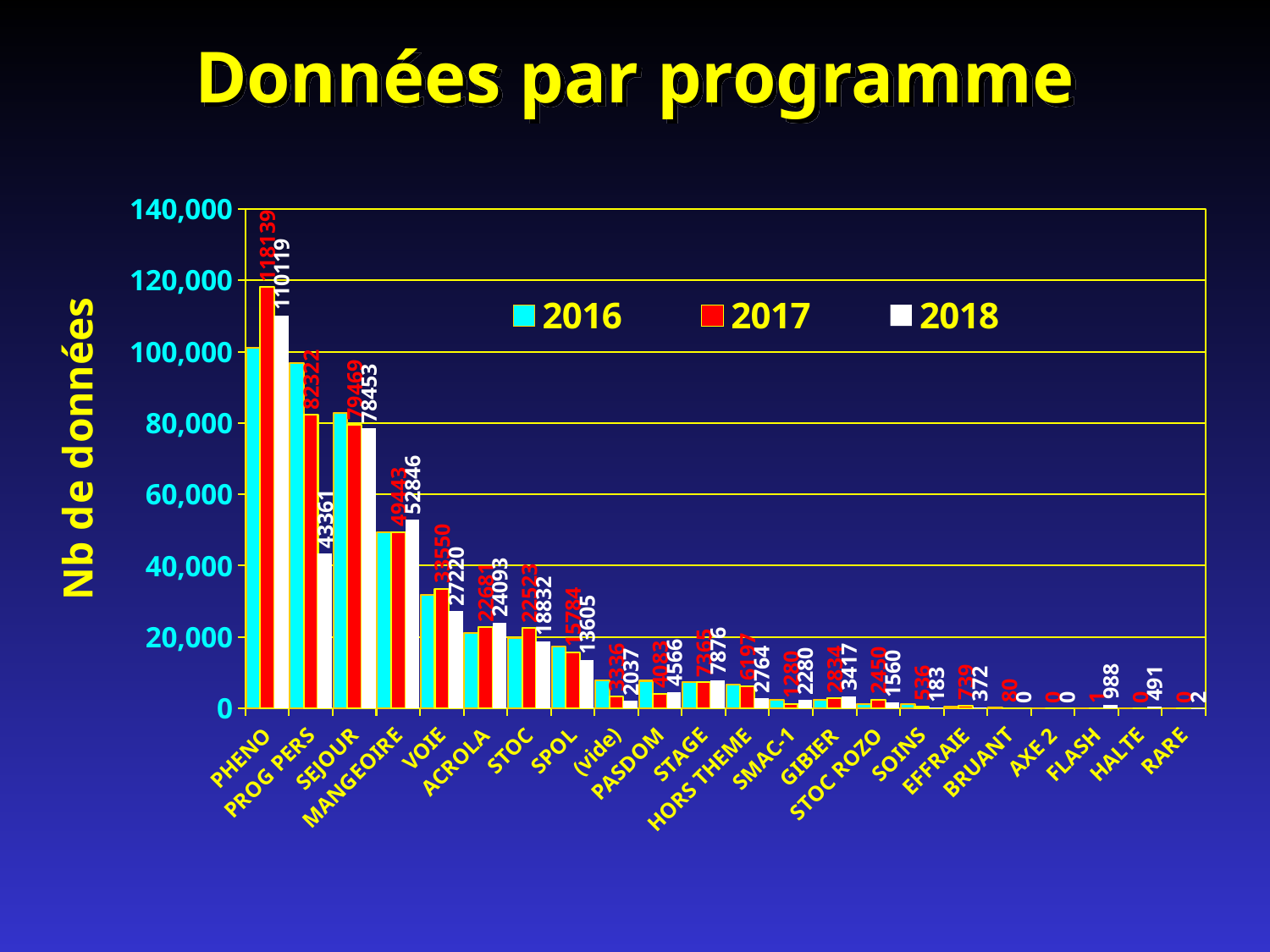
Is the 2016 value for VOIE greater or less than 20,000? greater Which programme has the highest 2018 value? PHENO What is the 2018 value for MANGEOIRE? 52846 What is the 2018 value for PHENO? 110119 What kind of chart is shown on the slide? bar chart How many programme categories are shown on the x axis? 22 What is the difference between the 2017 and 2018 values for PROG PERS? 38961 What is the 2018 value for HALTE? 491 Which is larger in 2018: MANGEOIRE or PROG PERS? MANGEOIRE How many series does the legend list? 3 What is the title of the y axis? Nb de données What is the 2018 value for SEJOUR? 78453